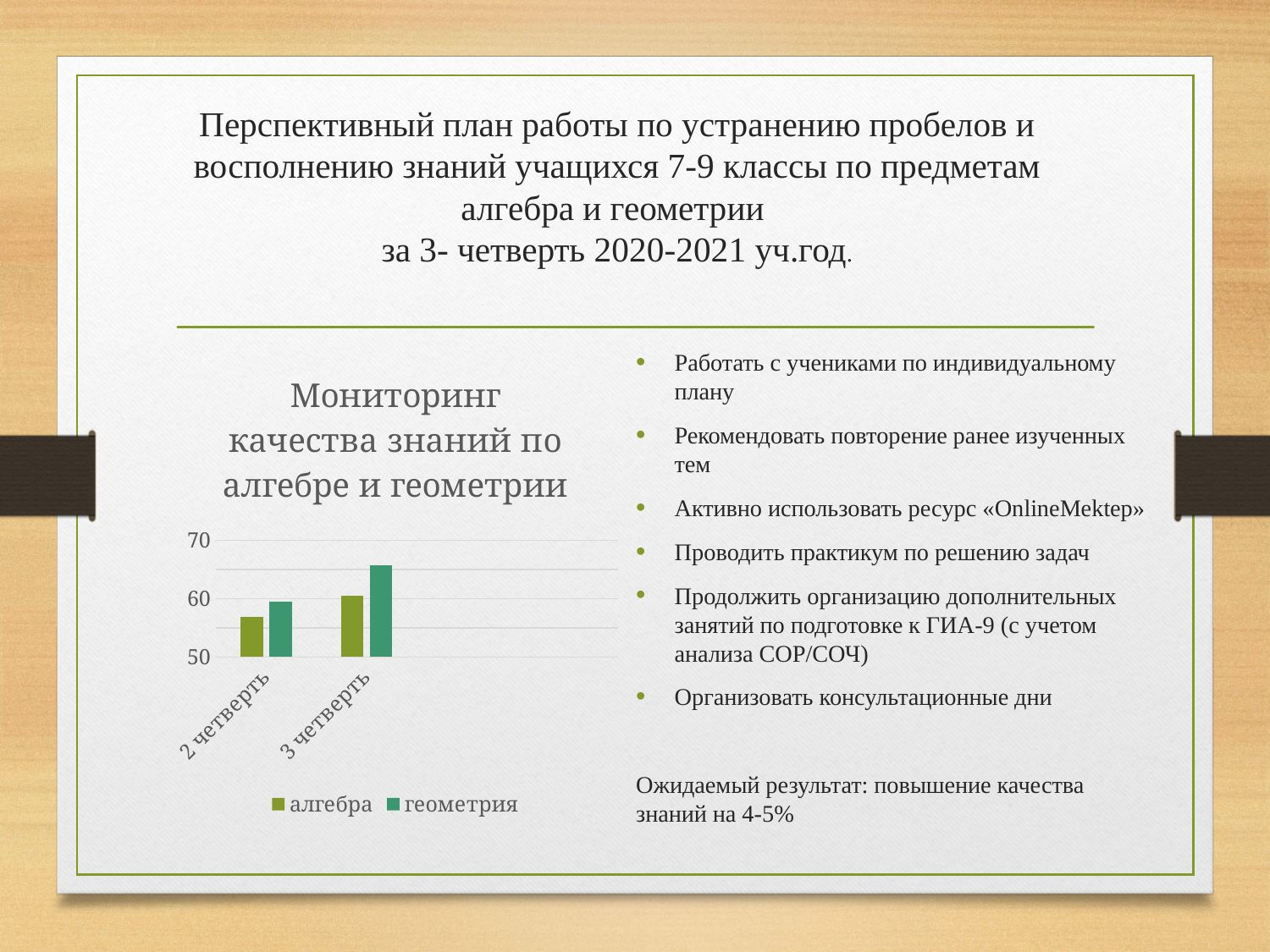
Which bar in the chart is the highest? геометрия, 3 четверть How many categories are shown on the x axis of the chart? 2 In 3 четверть, which series has the larger value, алгебра or геометрия? геометрия Which series are listed in the chart legend? алгебра, геометрия What kind of chart is shown on the slide? bar chart How many series does the chart legend list? 2 Which bar in the chart is the lowest? алгебра, 2 четверть Is the value for геометрия in 3 четверть greater or less than 70? less What is the title of the chart on the slide? Мониторинг качества знаний по алгебре и геометрии Do the values for алгебра rise or fall from 2 четверть to 3 четверть? rise Is the value for алгебра in 2 четверть greater or less than 60? less Is the value for геометрия in 3 четверть greater or less than 60? greater